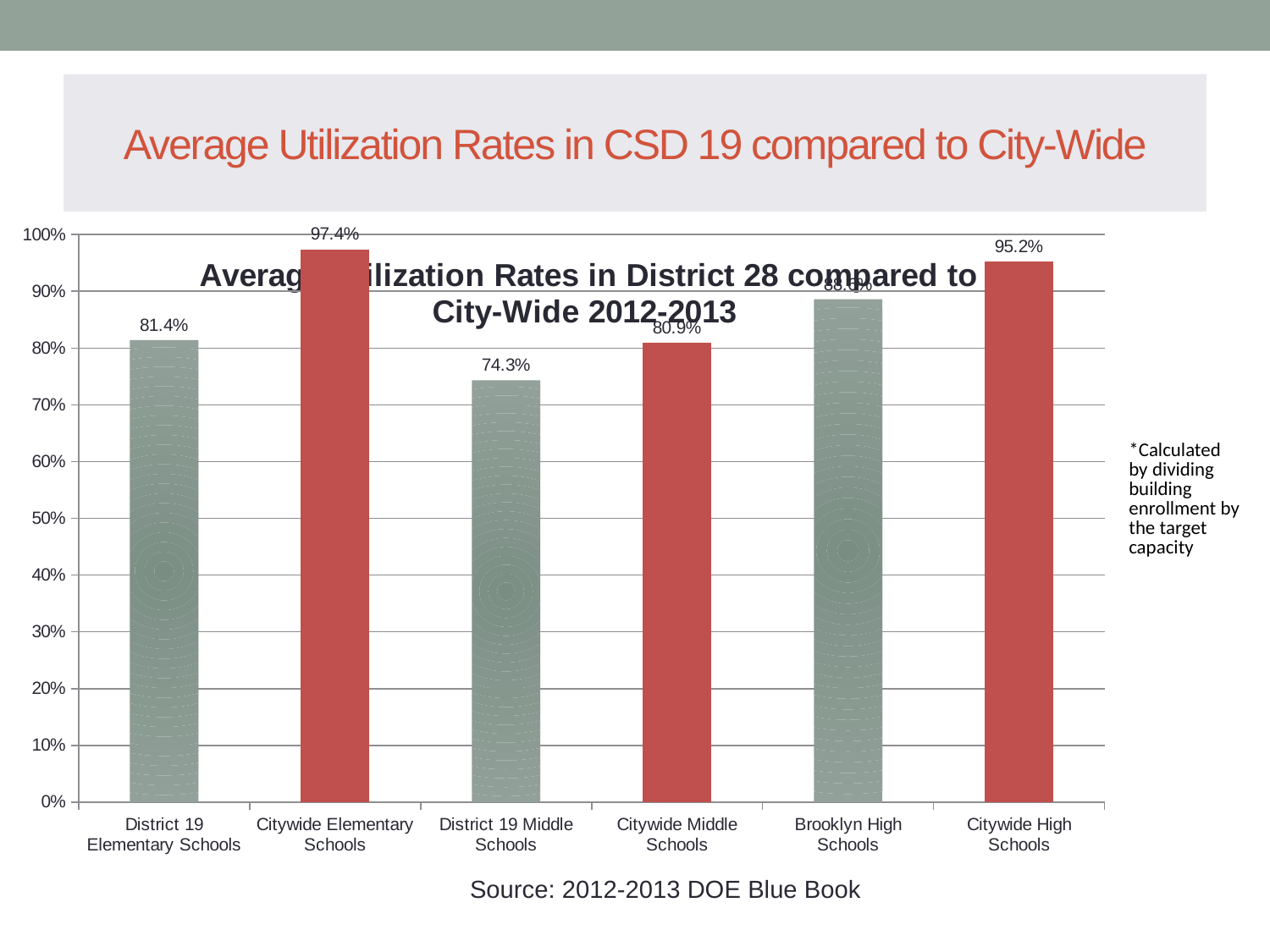
How much higher is the utilization rate for Citywide Elementary Schools than for District 19 Elementary Schools? 16.0% What is the average utilization rate for Citywide Middle Schools? 80.9% What is the difference between the utilization rates of Citywide Middle Schools and District 19 Middle Schools? 6.6% What is the average utilization rate for District 19 Middle Schools? 74.3% How many categories are shown on the x axis of the chart? 6 What is the average utilization rate for Citywide High Schools? 95.2% What type of chart is shown on the slide? Bar chart Is the utilization rate for Brooklyn High Schools greater or less than 80%? greater What is the average utilization rate for Citywide Elementary Schools? 97.4% Which category has the highest utilization rate? Citywide Elementary Schools Which category has the lowest utilization rate? District 19 Middle Schools What is the average utilization rate for District 19 Elementary Schools? 81.4%